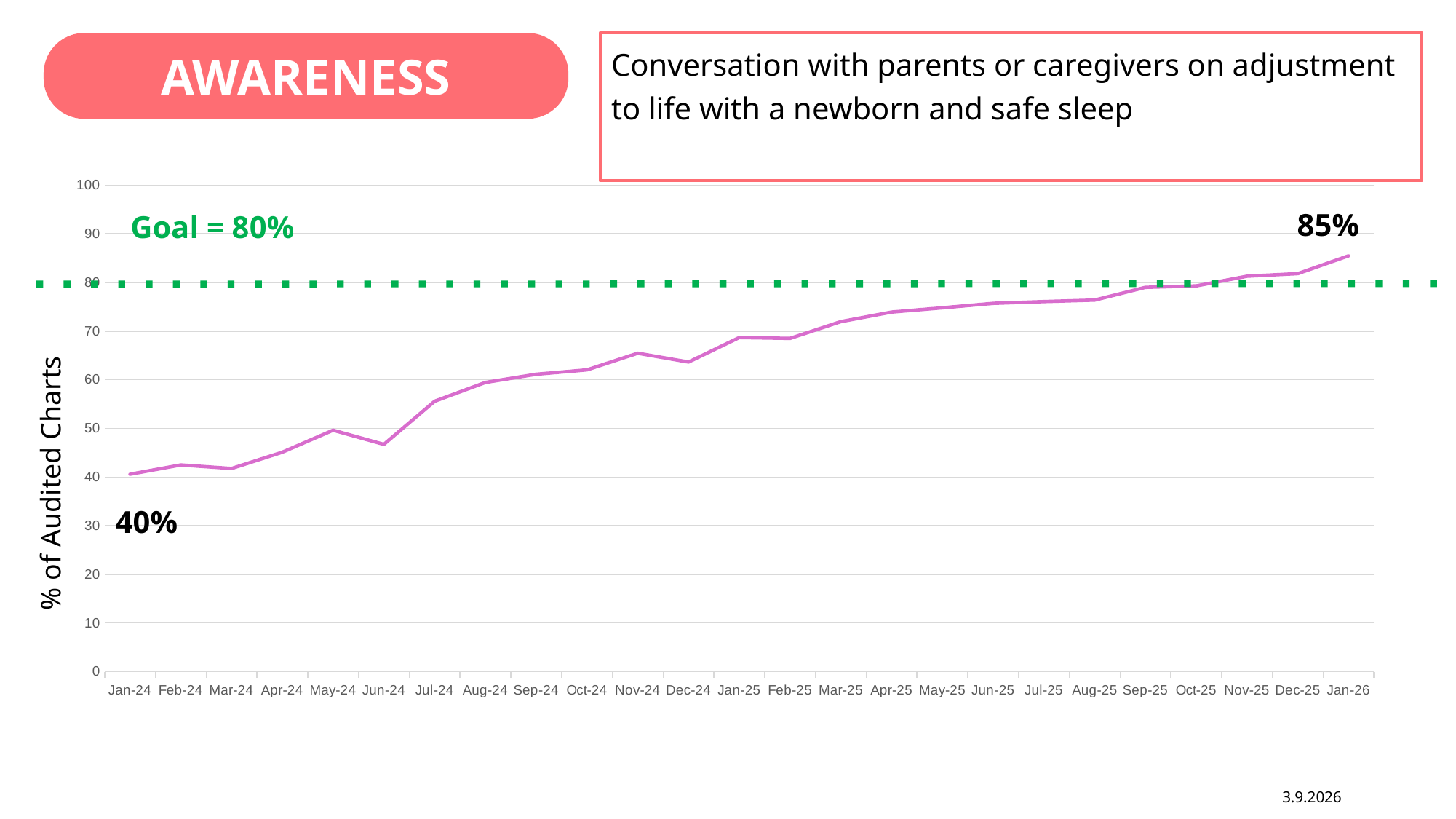
Which month has the lowest value? Jan-24 Is the value for Jun-24 greater or less than 50? less Is the value for Aug-25 greater or less than 80? less What is the value for Jan-24? 40% How many months are plotted on the x axis? 25 What is the value for Jan-26? 85% Which is larger, the value for May-24 or the value for Jun-24? May-24 What kind of chart is shown on the slide? line chart What is the difference between the Jan-26 value and the Jan-24 value? 45% Is the value for Mar-25 greater or less than 70? greater Which month has the highest value? Jan-26 Do the values generally rise or fall from Jan-24 to Jan-26? rise